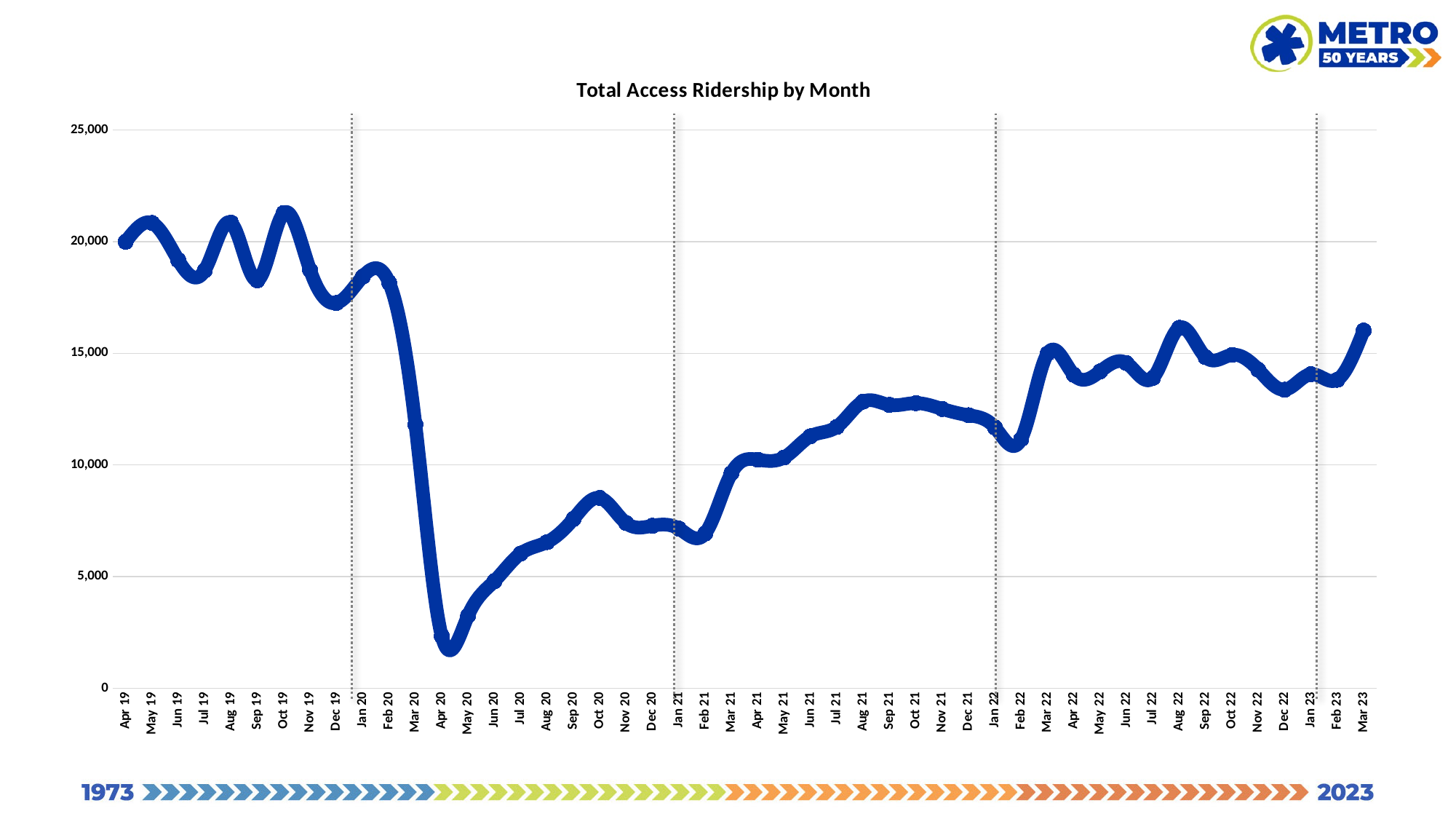
Do the values generally rise or fall from Apr 20 to Aug 21? rise Which is larger, the value for Apr 19 or the value for Apr 20? Apr 19 Is the value for Apr 20 greater or less than 5,000? less What kind of chart is shown on the slide? line chart Which month has the lowest ridership on the chart? Apr 20 Is the value for Mar 23 greater or less than 15,000? greater Do the values rise or fall from Jan 20 to Apr 20? fall What is the title of the chart? Total Access Ridership by Month How many monthly data points are plotted on the chart? 48 Is the value for Jan 22 greater or less than 10,000? greater